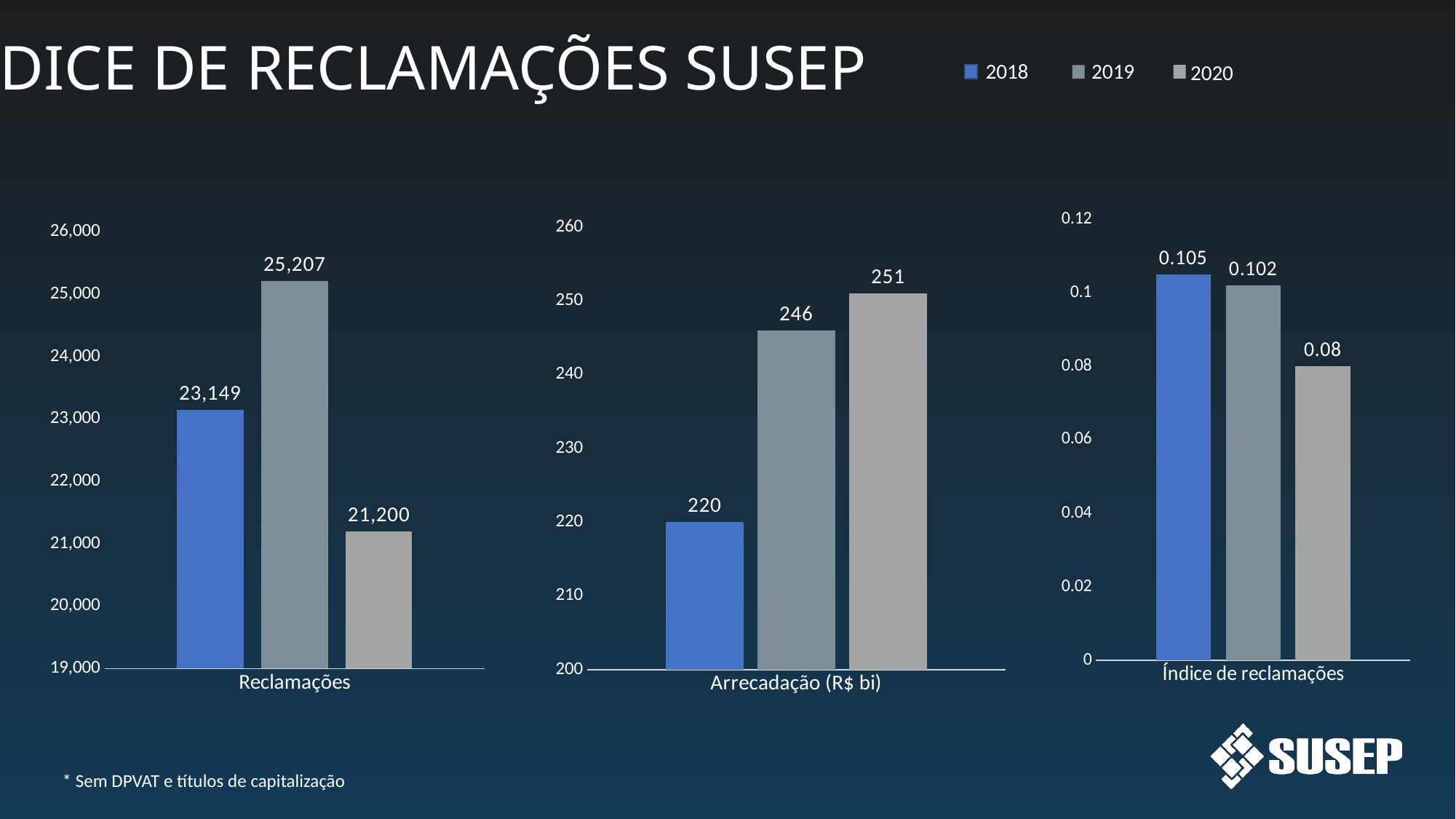
In the Arrecadação (R$ bi) chart, do the values rise or fall from 2018 to 2020? rise In the Reclamações chart, which is larger, the value for 2018 or the value for 2020? 2018 In the Índice de reclamações chart, which year has the highest value? 2018 In the Arrecadação (R$ bi) chart, what is the difference between the 2020 and 2018 values? 31 What kind of chart is the Arrecadação (R$ bi) chart? bar chart In the Índice de reclamações chart, is the value for 2020 greater or less than 0.1? less How many series does the legend at the top of the slide list? 3 In the Reclamações chart, what is the value for 2019? 25,207 In the Arrecadação (R$ bi) chart, what is the value for 2020? 251 In the Reclamações chart, what is the difference between the 2019 and 2018 values? 2,058 In the Índice de reclamações chart, what is the value for 2018? 0.105 In the Reclamações chart, which year has the lowest value? 2020